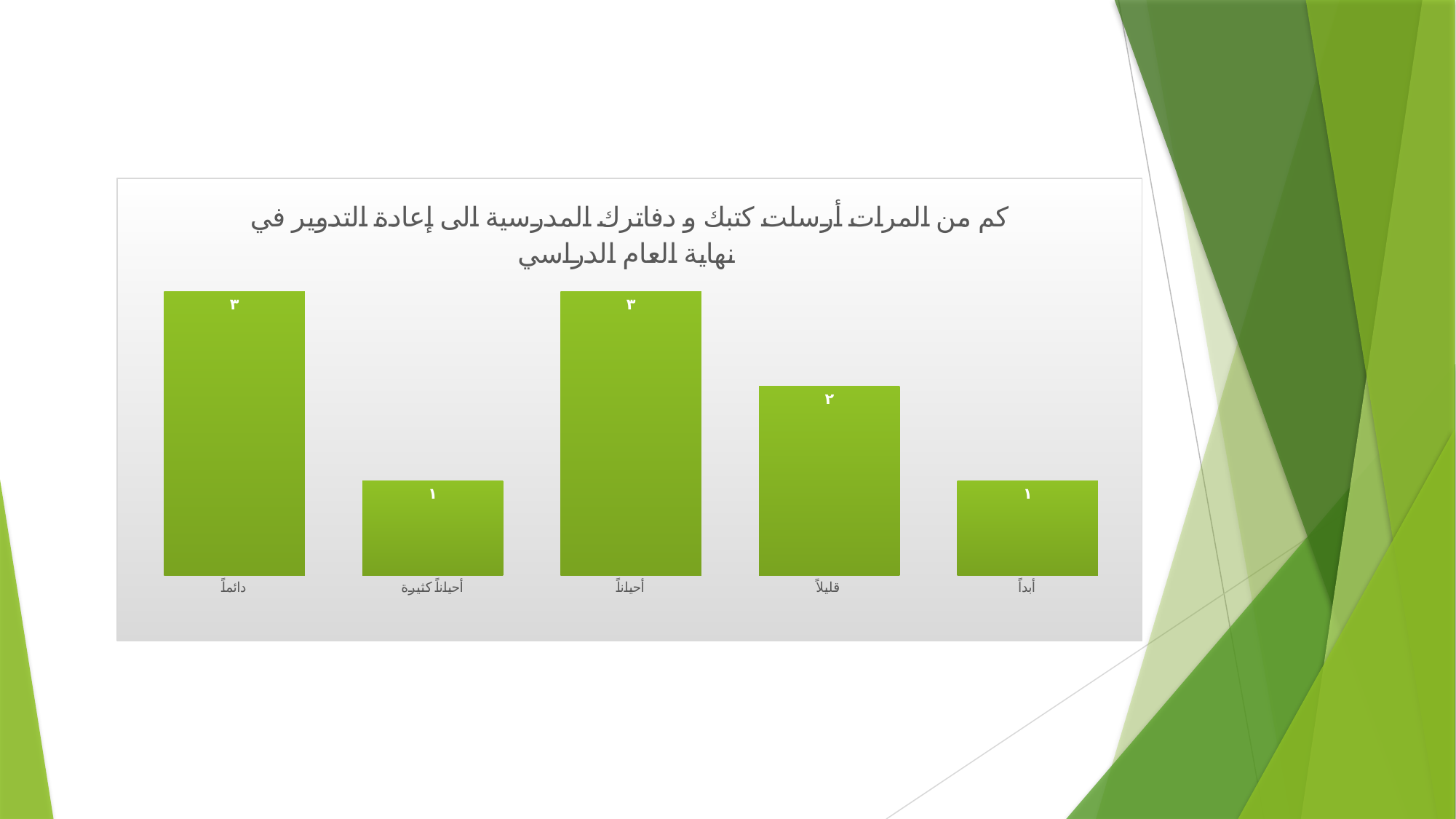
What kind of chart is shown on the slide? Bar chart What value is shown for the category أبداً? ١ How many categories are shown in the chart? 5 Which is larger, the value for أحياناً كثيرة or the value for أحياناً? أحياناً Which is larger, the value for قليلاً or the value for أبداً? قليلاً What value is shown for the category أحياناً كثيرة? ١ What is the difference between the value for دائماً and the value for قليلاً? ١ What value is shown for the category دائماً? ٣ What value is shown for the category قليلاً? ٢ What value is shown for the category أحياناً? ٣ What is the difference between the value for أحياناً and the value for أبداً? ٢ What colour are the bars in the chart? Green